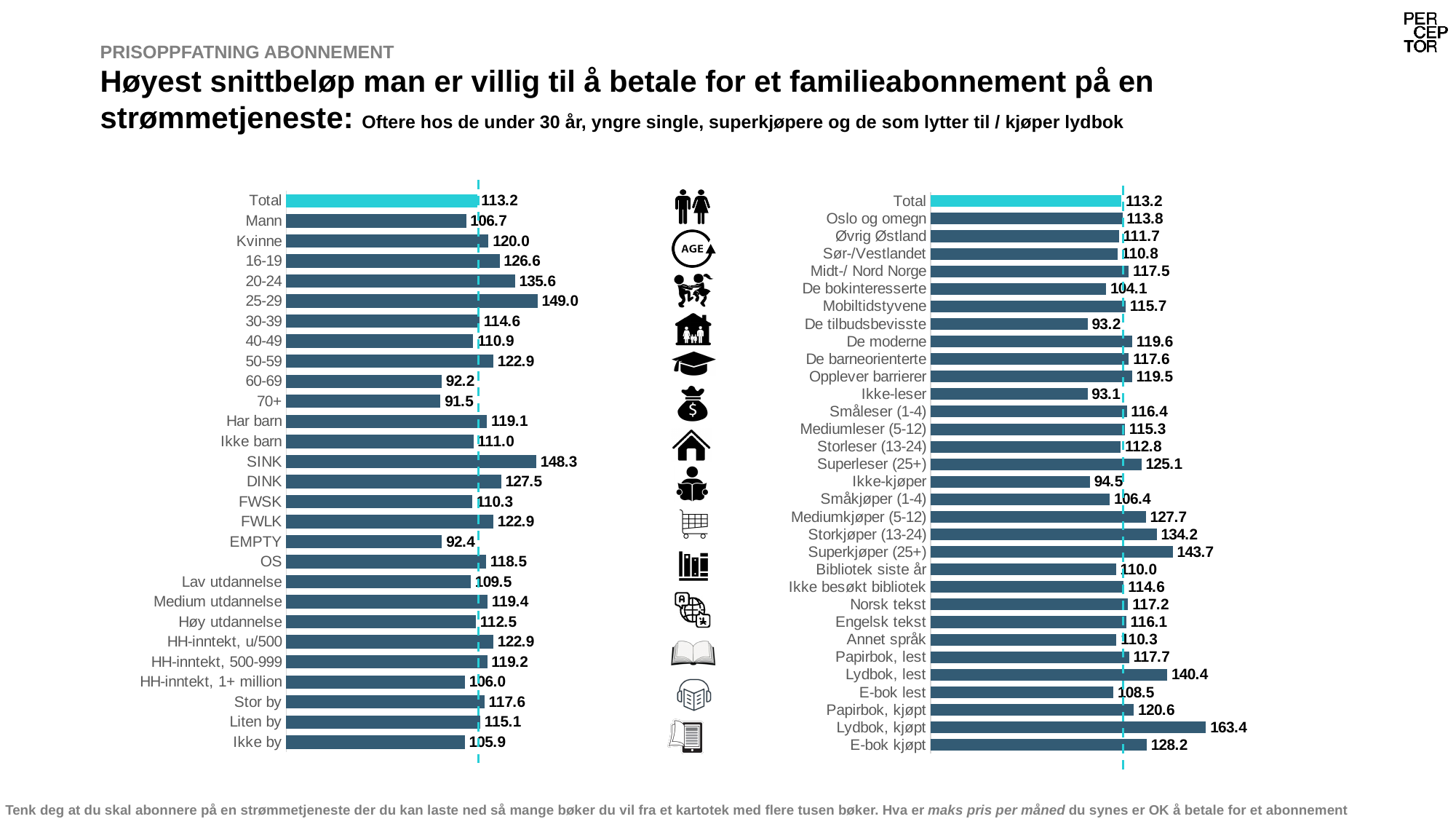
On the right chart, what is the value for Lydbok, kjøpt? 163.4 How many categories are shown on the right chart? 32 On the left chart, which category has the highest value? 25-29 On the left chart, what is the difference between the values for Kvinne and Mann? 13.3 How many categories are shown on the left chart? 28 What type of chart is used on the left side of the slide? Bar chart On the left chart, what is the value for Total? 113.2 On the right chart, what is the value for De tilbudsbevisste? 93.2 On the right chart, which category has the highest value? Lydbok, kjøpt On the left chart, what is the value for 25-29? 149.0 On the left chart, which category has the lowest value? 70+ On the right chart, which is larger, the value for Superkjøper (25+) or the value for Superleser (25+)? Superkjøper (25+)